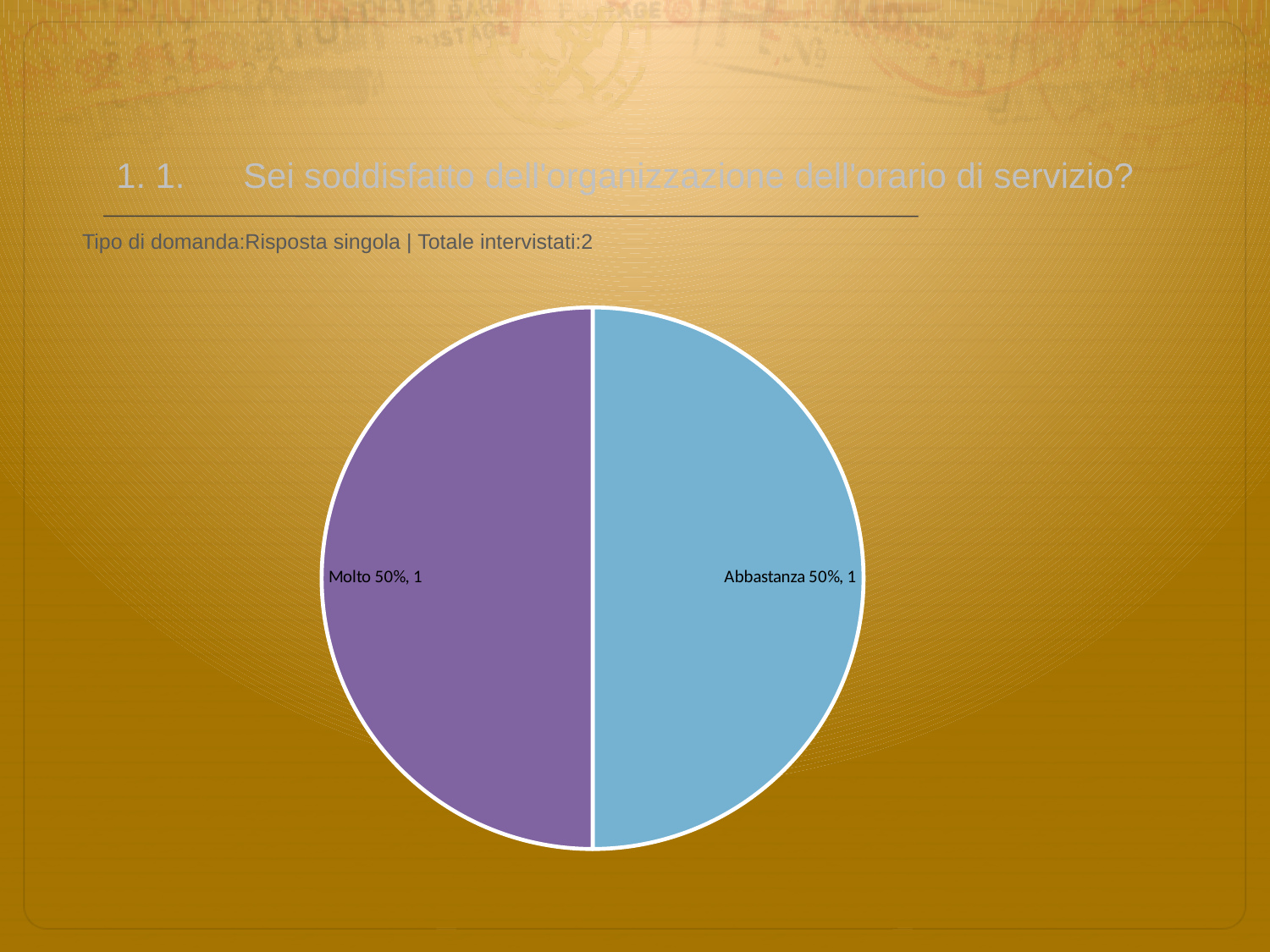
What is the total number of respondents shown on the slide? 2 What share of the pie does the "Molto" slice represent? 50% What colour is the "Molto" slice? purple How many slices does the pie chart have? 2 What colour is the "Abbastanza" slice? light blue What kind of chart is shown on the slide? pie chart What is the count value shown for the "Abbastanza" slice? 1 What is the count value shown for the "Molto" slice? 1 What is the difference between the counts for "Molto" and "Abbastanza"? 0 What share of the pie does the "Abbastanza" slice represent? 50%